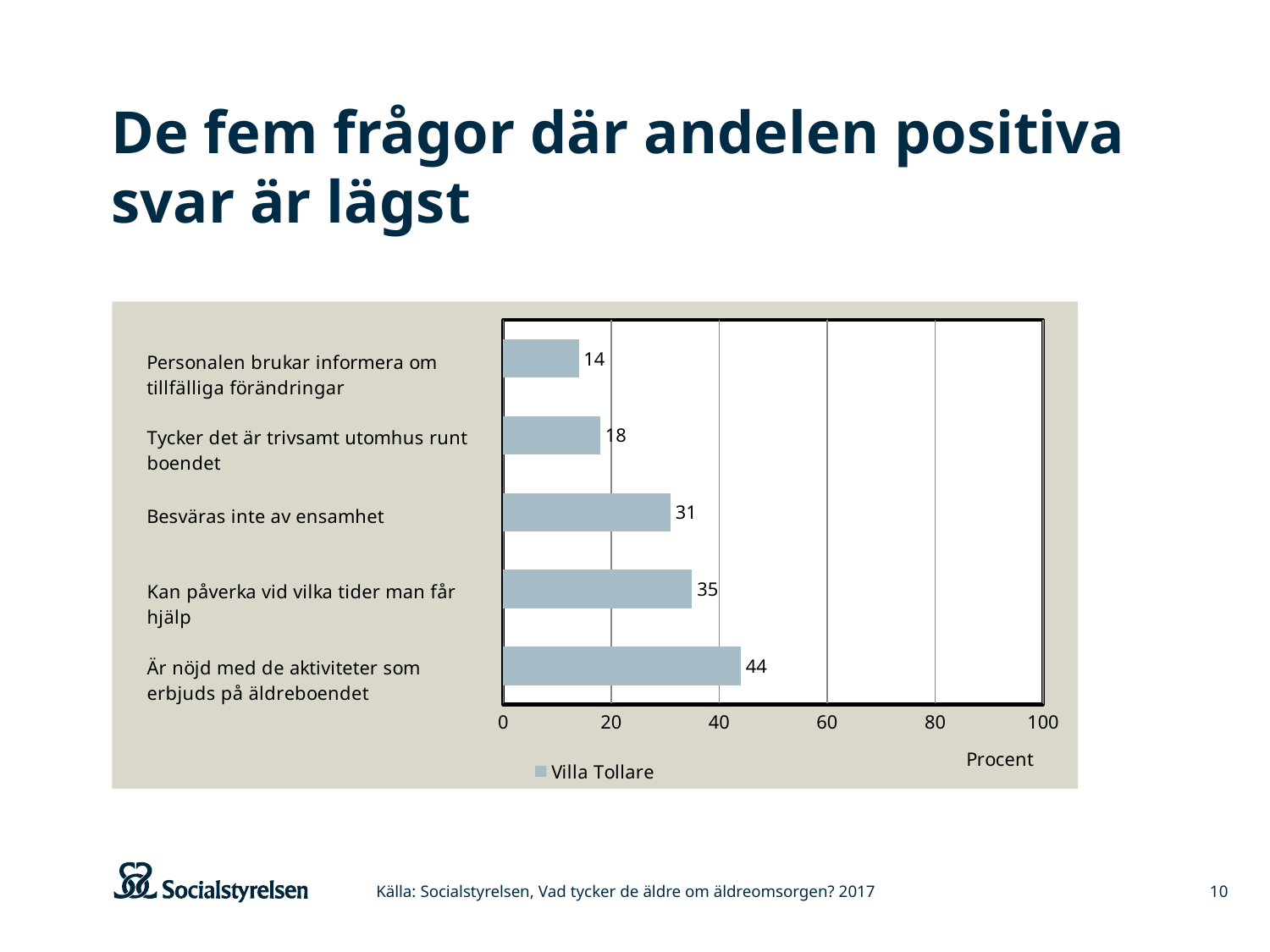
What kind of chart is shown on the slide? bar chart What is the value for "Besväras inte av ensamhet"? 31 Which is larger: the value for "Besväras inte av ensamhet" or the value for "Kan påverka vid vilka tider man får hjälp"? Kan påverka vid vilka tider man får hjälp Is the value for "Är nöjd med de aktiviteter som erbjuds på äldreboendet" greater or less than 40? greater Which category has the highest value? Är nöjd med de aktiviteter som erbjuds på äldreboendet What is the value for "Är nöjd med de aktiviteter som erbjuds på äldreboendet"? 44 How many series does the legend list? 1 What is the value for "Personalen brukar informera om tillfälliga förändringar"? 14 How many categories are shown in the chart? 5 What is the difference between the values for "Kan påverka vid vilka tider man får hjälp" and "Tycker det är trivsamt utomhus runt boendet"? 17 Which category has the lowest value? Personalen brukar informera om tillfälliga förändringar What is the name of the series shown in the legend? Villa Tollare